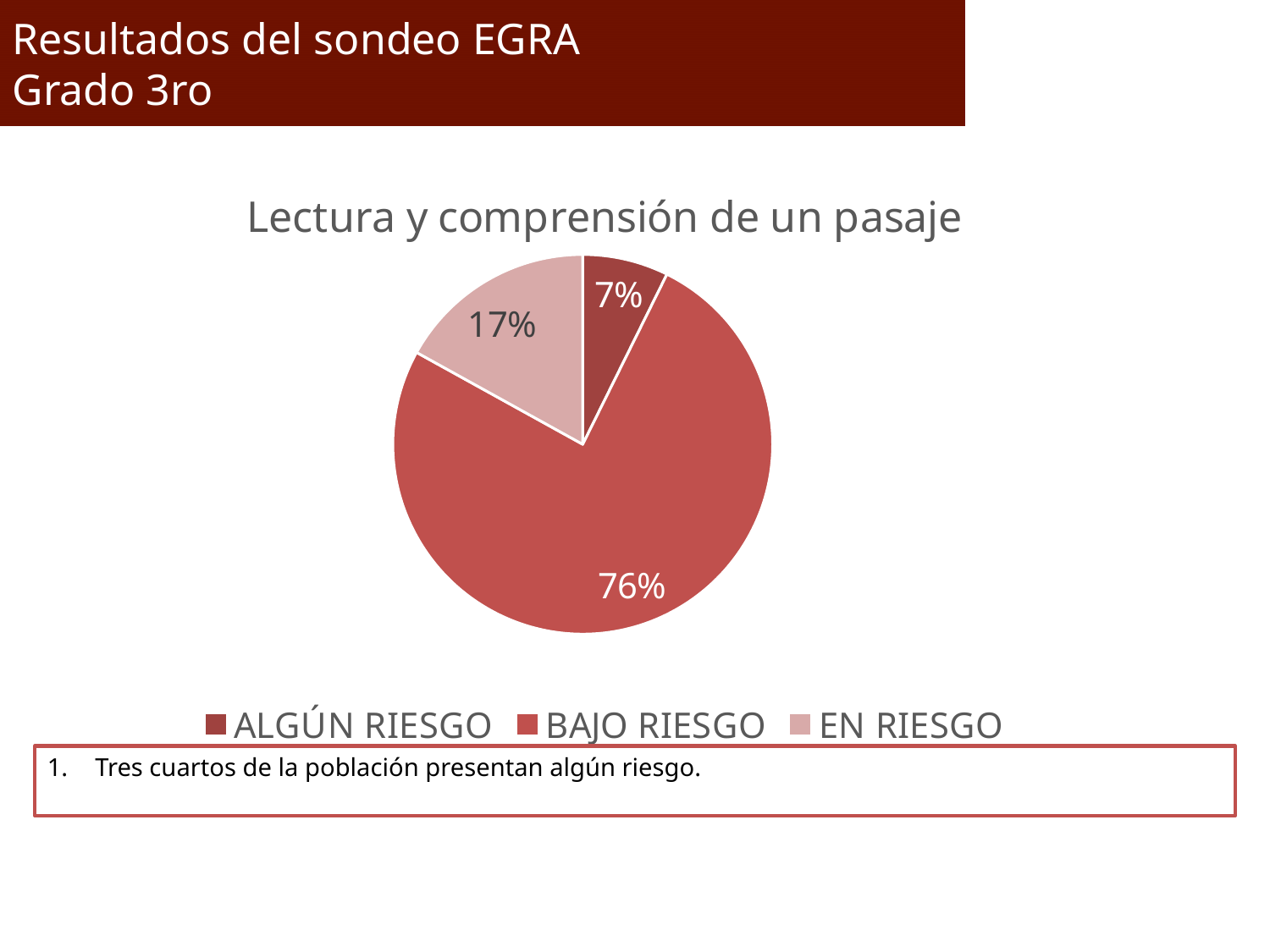
Which legend entry is shown with the lightest pink colour? EN RIESGO What percentage is shown for the ALGÚN RIESGO slice? 7% What percentage is shown for the EN RIESGO slice? 17% What is the difference between the EN RIESGO share and the ALGÚN RIESGO share? 10% What percentage is shown for the BAJO RIESGO slice? 76% Which category has the largest share of the pie? BAJO RIESGO What is the title of the pie chart? Lectura y comprensión de un pasaje How many entries does the legend list? 3 Which category has the smallest share of the pie? ALGÚN RIESGO Which is larger, the EN RIESGO slice or the ALGÚN RIESGO slice? EN RIESGO What kind of chart is shown on the slide? pie chart How many slices does the pie chart have? 3